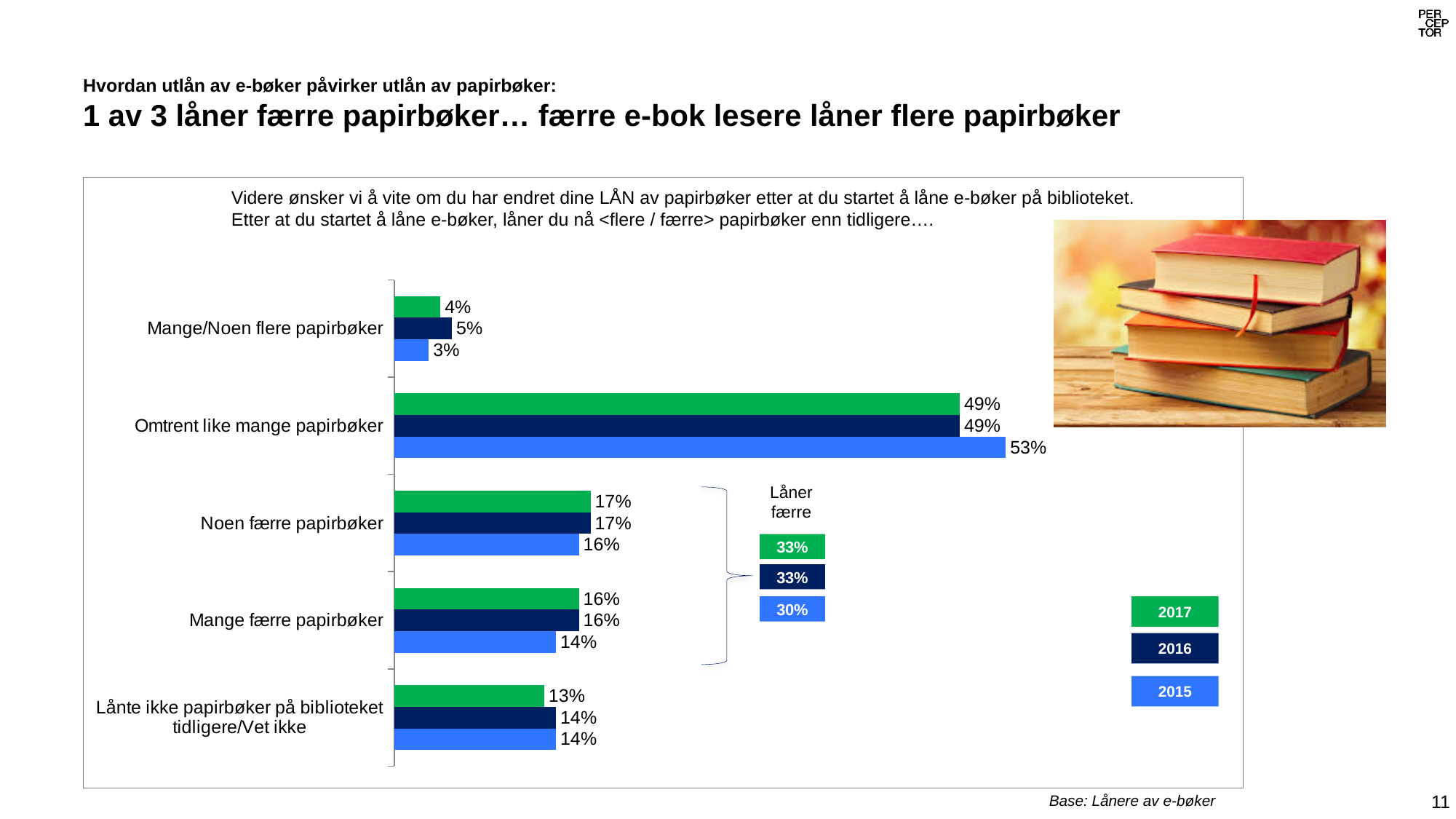
Which colour represents the 2016 series in the legend? dark navy blue What is the difference between the 2015 and 2017 values for "Omtrent like mange papirbøker"? 4% Which is larger for "Noen færre papirbøker": the 2016 value or the 2015 value? 2016 How many categories are shown on the chart? 5 What kind of chart is shown on the slide? bar chart What is the 2015 value for "Mange færre papirbøker"? 14% How many series does the legend list? 3 Which category has the lowest value for 2015? Mange/Noen flere papirbøker Which category has the highest value for 2017? Omtrent like mange papirbøker What is the 2015 value for "Omtrent like mange papirbøker"? 53% What is the 2016 value for "Lånte ikke papirbøker på biblioteket tidligere/Vet ikke"? 14% What is the 2017 value for "Mange/Noen flere papirbøker"? 4%